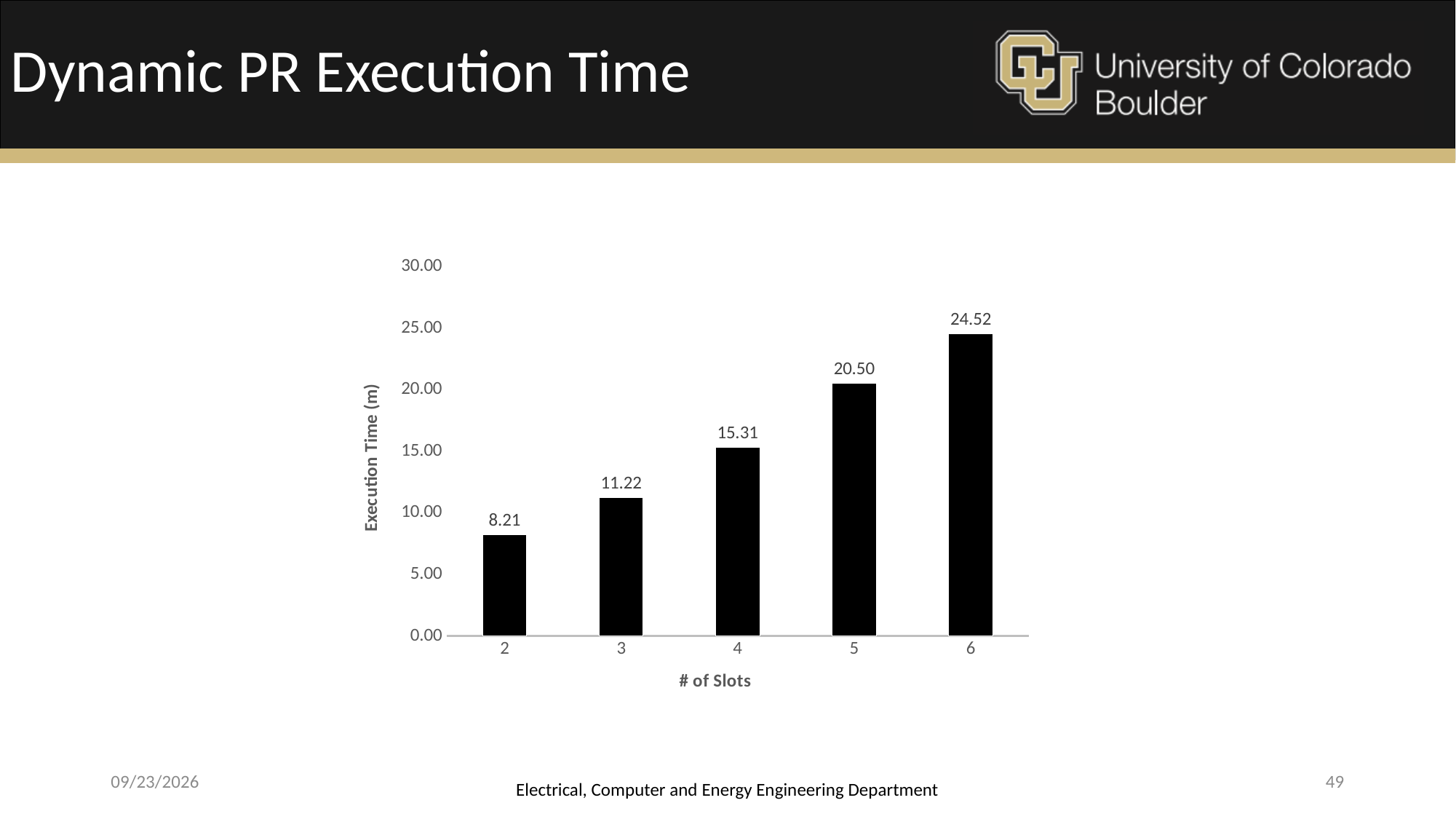
Is the execution time for 5 slots greater or less than 20.00? greater Which number of slots has the highest execution time? 6 What kind of chart is shown on the slide? Bar chart What is the execution time for 2 slots? 8.21 Does execution time rise or fall as the number of slots increases? Rises Which has a larger execution time, 3 slots or 4 slots? 4 slots What is the execution time for 6 slots? 24.52 What is the execution time for 4 slots? 15.31 What is the label of the y axis? Execution Time (m) Which number of slots has the lowest execution time? 2 What is the difference in execution time between 5 slots and 3 slots? 9.28 How many slot counts are plotted on the chart? 5